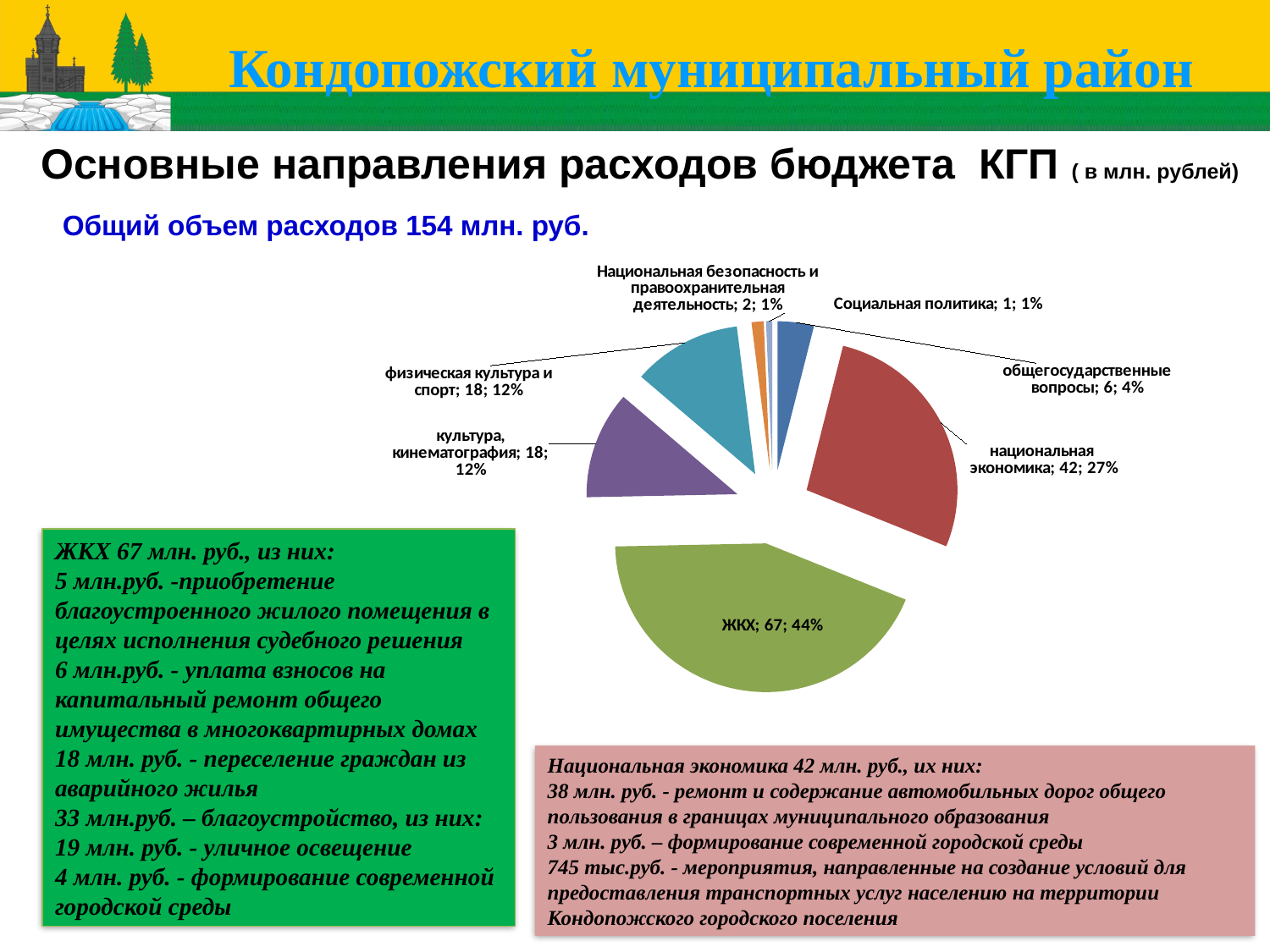
What is the difference between the values for ЖКХ and национальная экономика? 25 Which category has the smallest slice of the pie? Социальная политика What total volume of expenditure is stated above the chart? 154 млн. руб. What share of the pie does национальная экономика have? 27% What value is shown for общегосударственные вопросы? 6 What share of the pie does физическая культура и спорт have? 12% What value is shown for Национальная безопасность и правоохранительная деятельность? 2 Which is larger, the value for культура, кинематография or the value for общегосударственные вопросы? культура, кинематография Which category has the largest slice of the pie? ЖКХ How many slices does the pie chart have? 7 What kind of chart is shown on the slide? pie chart What value is shown for ЖКХ in the pie chart? 67